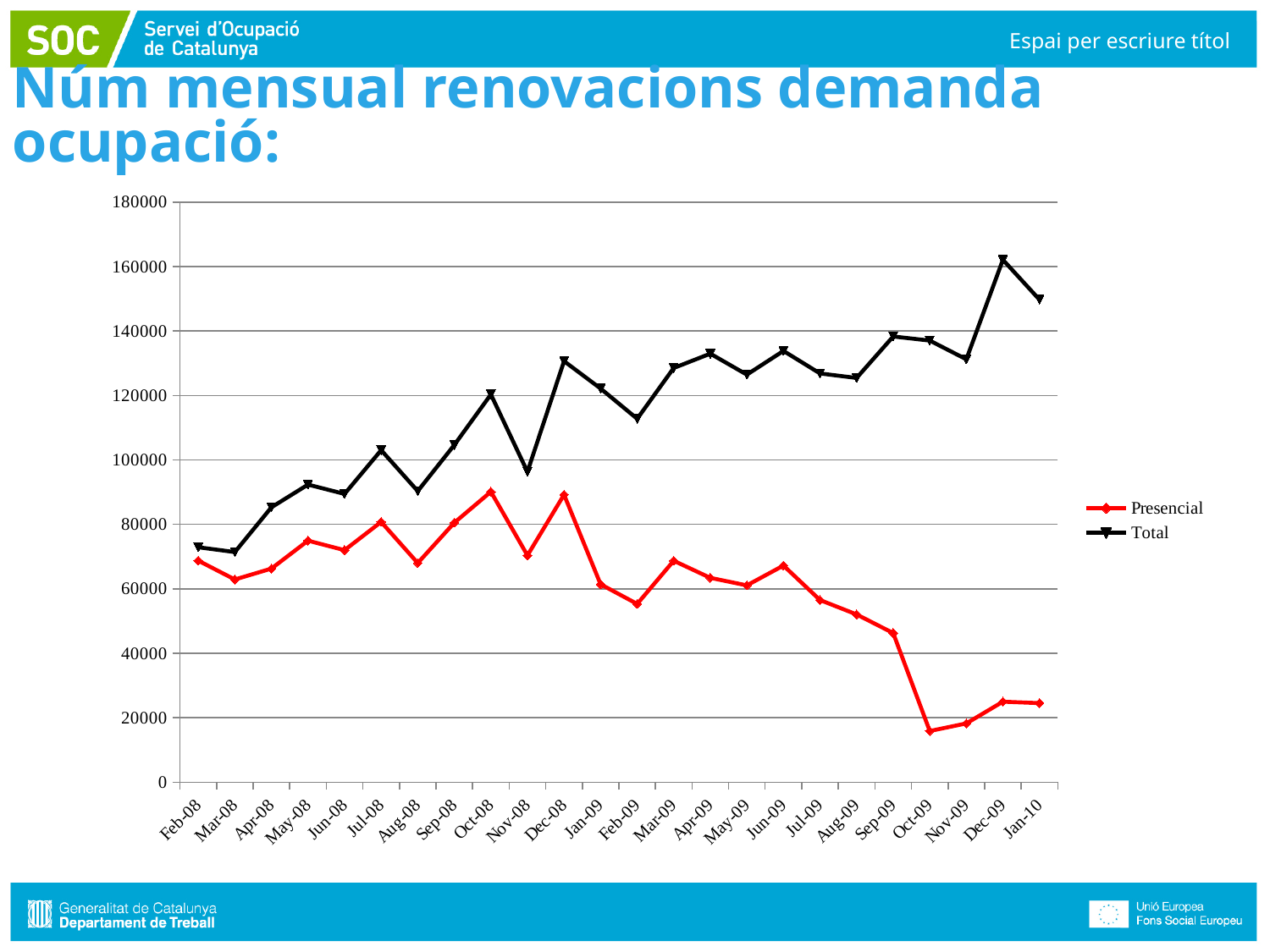
How many series does the legend list? 2 Does the Presencial series generally rise or fall from Feb-08 to Jan-10? fall Is the Total value for Nov-08 greater or less than 100000? less Is the Presencial value for Sep-09 greater or less than 40000? greater Is the Presencial value for Oct-09 greater or less than 20000? less Which is larger in Jan-10, the Total value or the Presencial value? Total In which month does the Presencial series reach its lowest value? Oct-09 What kind of chart is shown on the slide? line chart What colour is the line for the Total series? black How many months are plotted along the x axis? 24 In which month does the Total series reach its highest value? Dec-09